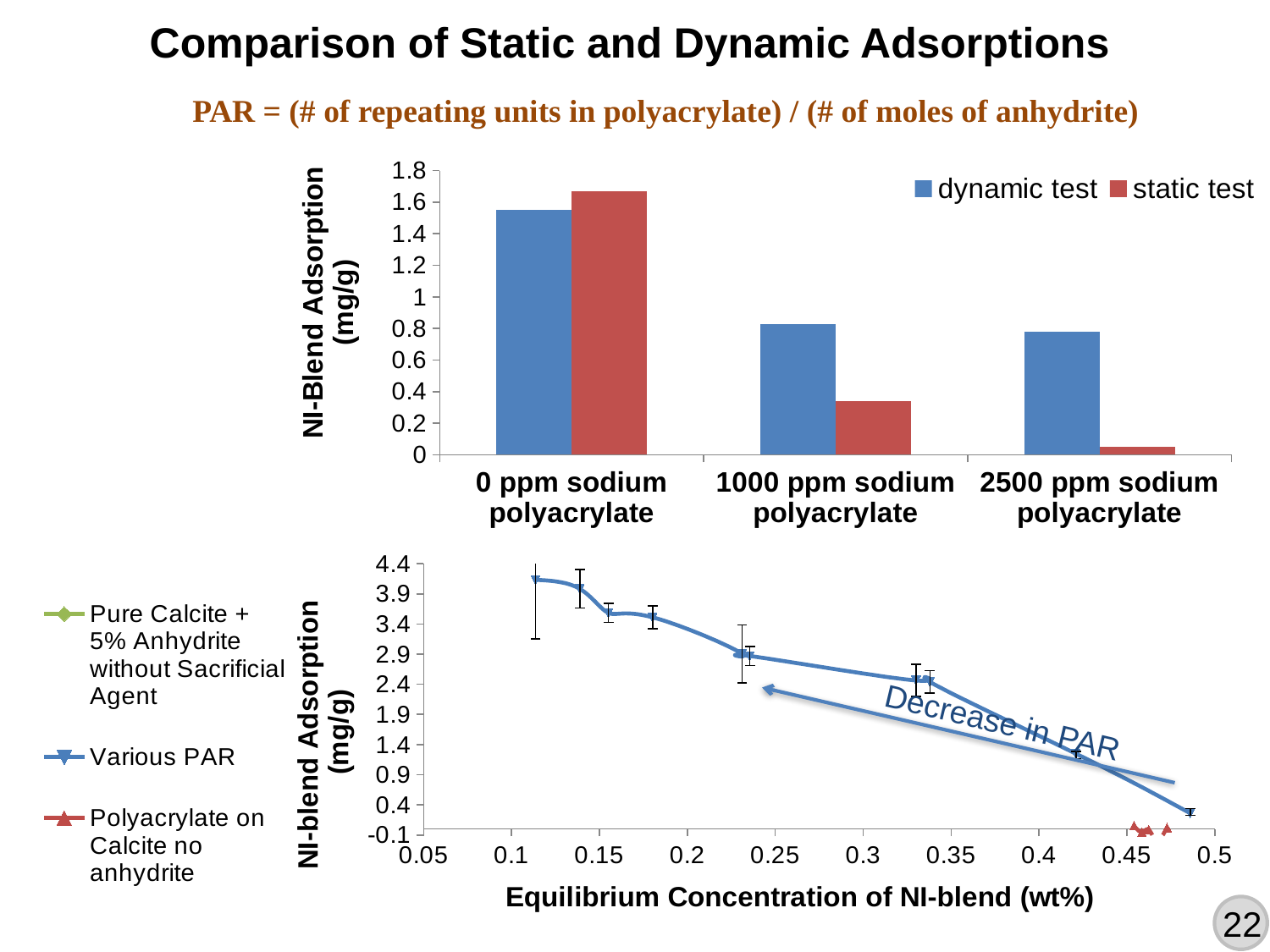
In the top bar chart, is the dynamic test value for 0 ppm sodium polyacrylate greater or less than 1.4? greater In the top bar chart, do the static test values rise or fall as the sodium polyacrylate concentration increases? fall How many series does the legend of the bottom chart list? 3 In the top bar chart, is the static test value for 1000 ppm sodium polyacrylate greater or less than 0.4? less How many categories are shown on the x axis of the top bar chart? 3 What kind of chart is the top chart on the slide? bar chart In the top bar chart, which category has the highest dynamic test value? 0 ppm sodium polyacrylate In the top bar chart, for 1000 ppm sodium polyacrylate, which is larger: the dynamic test or the static test value? dynamic test In the bottom chart, does the Various PAR series rise or fall as the equilibrium concentration of NI-blend increases? fall In the top bar chart, for 0 ppm sodium polyacrylate, which is larger: the dynamic test or the static test value? static test In the top bar chart, which category has the lowest static test value? 2500 ppm sodium polyacrylate How many series does the legend of the top bar chart list? 2